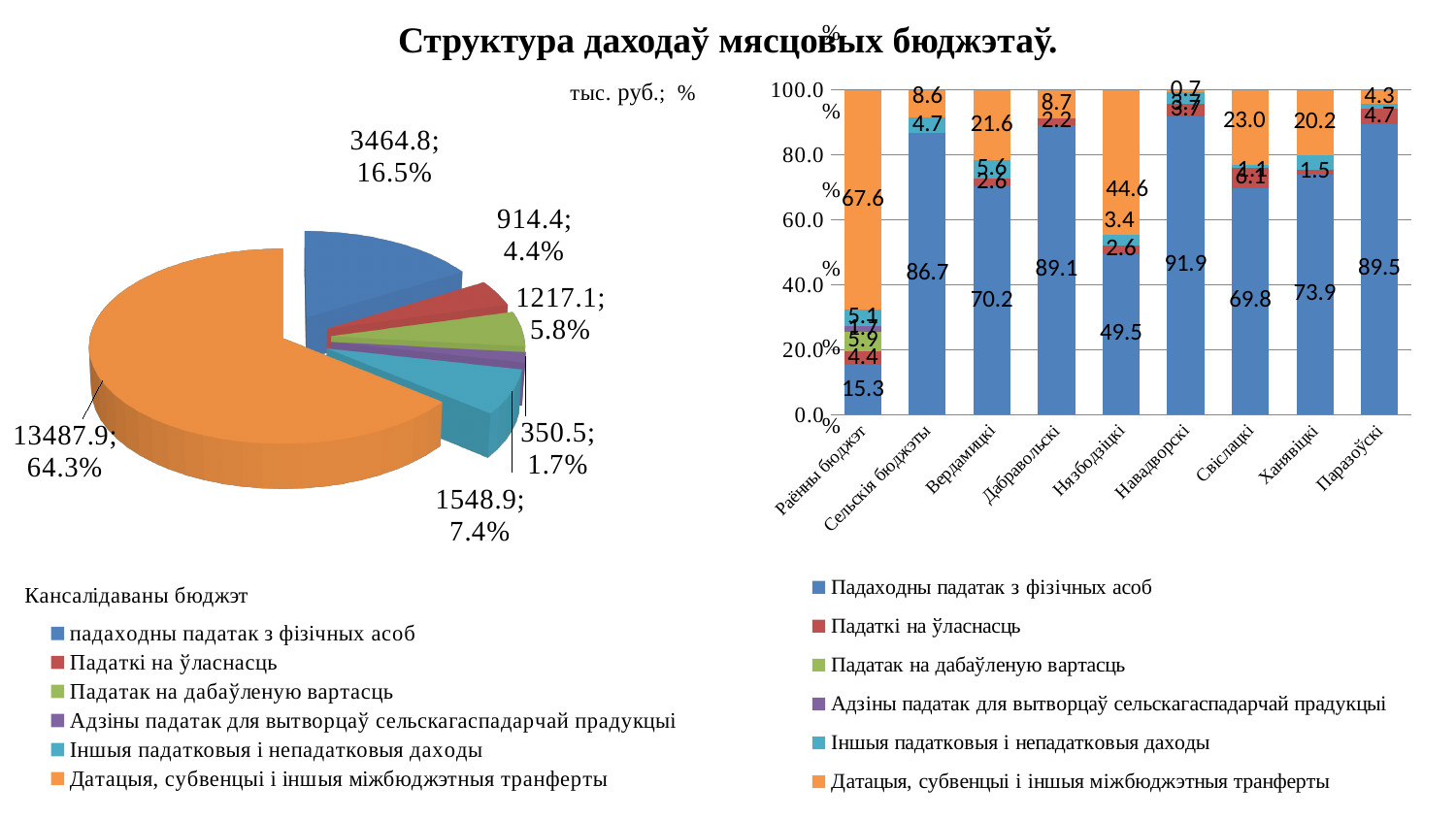
In the bar chart on the right, how many categories are shown on the x axis? 9 In the pie chart on the left, what value is shown for the slice 'Датацыі, субвенцыі і іншыя міжбюджэтныя трансферты'? 13487.9; 64.3% In the bar chart on the right, how many series does the legend list? 6 What kind of chart is the chart on the left? pie chart In the pie chart on the left, which category has the largest slice? Датацыя, субвенцыі і іншыя міжбюджэтныя транферты In the pie chart on the left, which category has the smallest slice? Адзіны падатак для вытворцаў сельскагаспадарчай прадукцыі What kind of chart is the chart on the right? stacked bar chart In the bar chart on the right, what is the difference between the 'Падаходны падатак з фізічных асоб' values for Сельскія бюджэты and Вердамiцкi? 16.5 In the bar chart on the right, which category has the lowest value for 'Падаходны падатак з фізічных асоб'? Раённы бюджэт In the pie chart on the left, what share does 'падаходны падатак з фізічных асоб' have? 16.5% In the bar chart on the right, what is the value of 'Падаходны падатак з фізічных асоб' for Навадворскі? 91.9 In the bar chart on the right, which has the larger value for 'Датацыі, субвенцыі і іншыя міжбюджэтныя трансферты': Раённы бюджэт or Свіслацкі? Раённы бюджэт